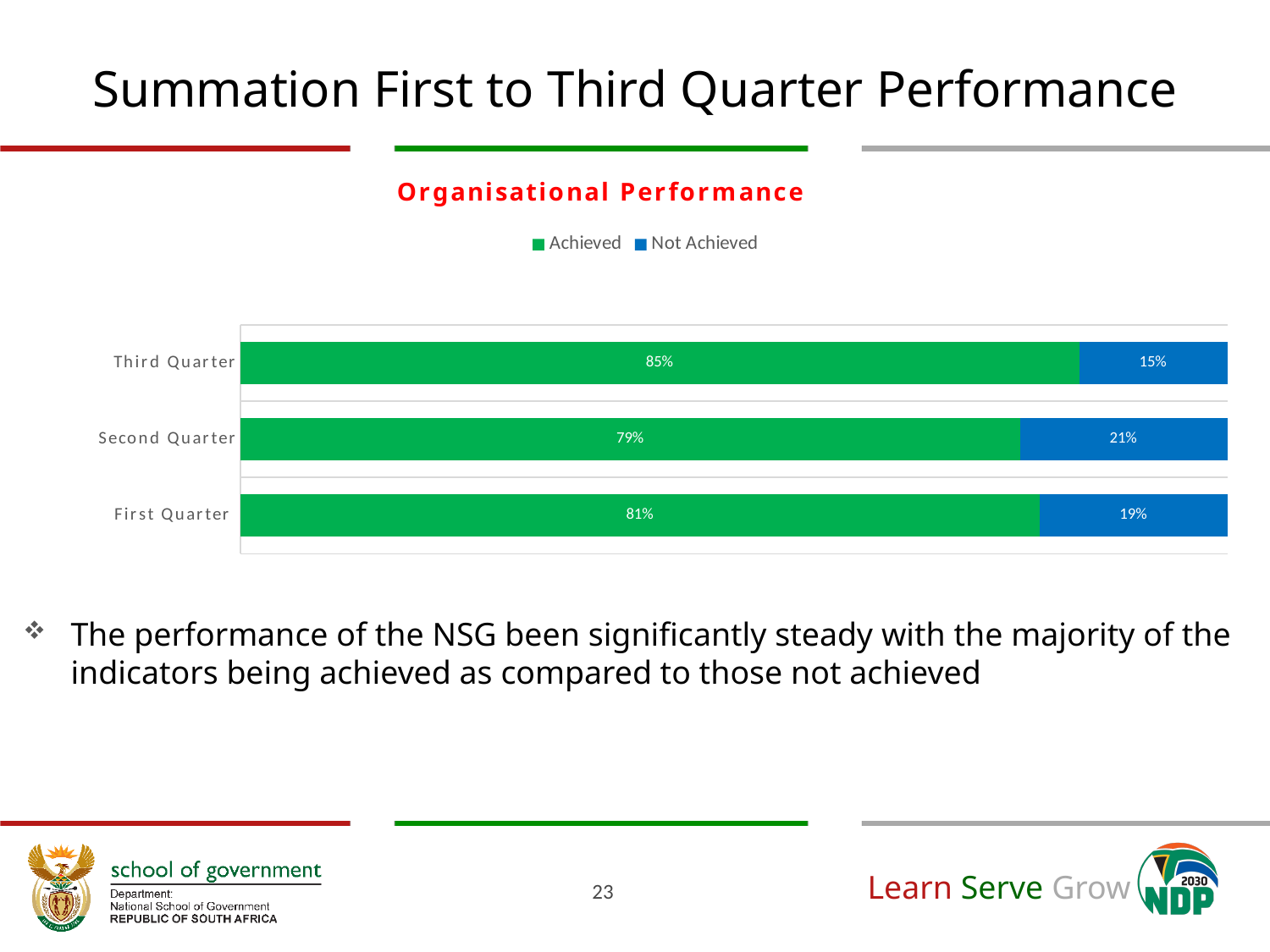
Which is larger, the Not Achieved value for the First Quarter or for the Third Quarter? First Quarter How many quarters are shown in the chart? 3 How many series does the legend list? 2 Which quarter has the lowest Achieved value? Second Quarter What is the Not Achieved value for the Second Quarter? 21% What kind of chart is shown on the slide? Stacked bar chart What is the Achieved value for the Third Quarter? 85% What is the title of the chart? Organisational Performance What is the difference between the Achieved values for the Third Quarter and the Second Quarter? 6% What is the Achieved value for the First Quarter? 81% Which quarter has the highest Achieved value? Third Quarter What is the total of the stacked bar for the Second Quarter? 100%